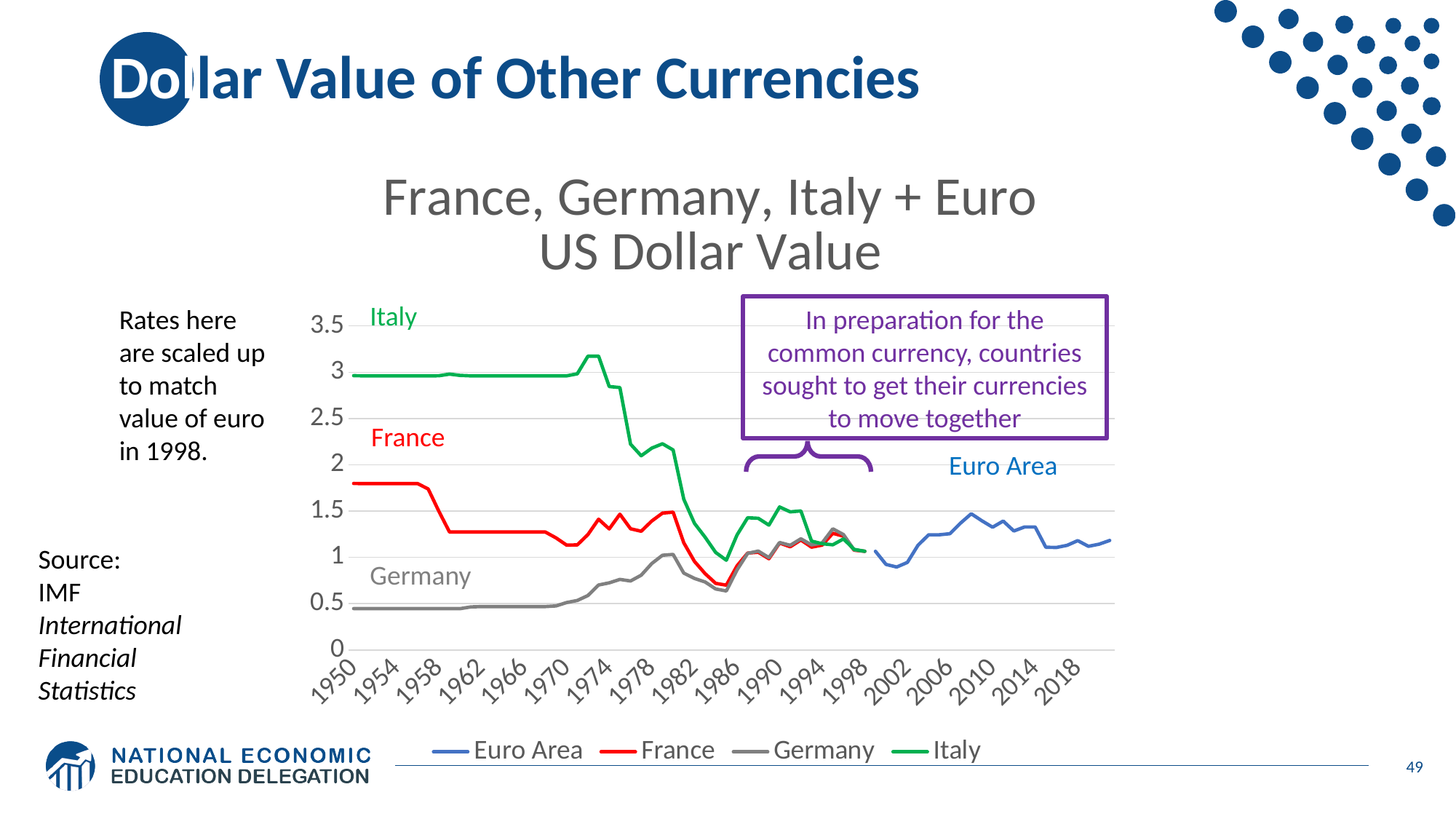
Does the Italy line rise or fall between 1950 and 1986? fall What is the title of the chart? France, Germany, Italy + Euro US Dollar Value Is the value for Germany in 1950 greater or less than 1? less How many series does the chart legend list? 4 Is the value for France in 1950 greater or less than 1.5? greater Which series has the lowest value in 1950? Germany Is the value for Italy in 1950 greater or less than 2.5? greater What kind of chart is shown on the slide? line chart In 1950, which is higher, France or Germany? France Which series has the highest value in 1950? Italy What are the series listed in the chart legend? Euro Area, France, Germany, Italy